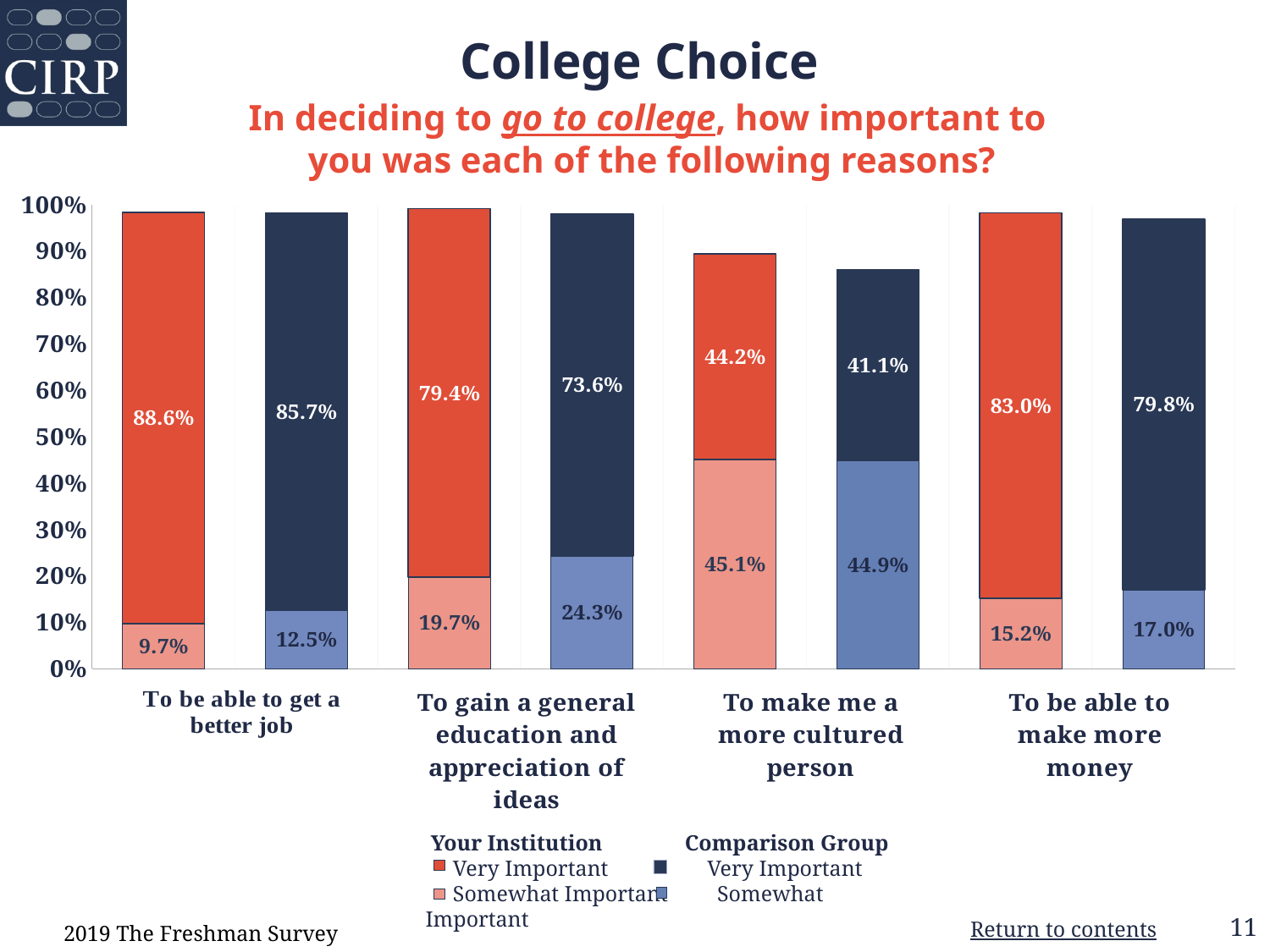
Which reason has the highest Very Important percentage for Your Institution? To be able to get a better job What percentage of Your Institution students rated "To be able to get a better job" as Very Important? 88.6% What kind of chart is shown on the slide? Stacked bar chart What colour represents Very Important for Your Institution? Red For "To gain a general education and appreciation of ideas", which group has the larger Very Important percentage, Your Institution or the Comparison Group? Your Institution What is the difference between Your Institution's and the Comparison Group's Very Important percentages for "To be able to make more money"? 3.2 percentage points What percentage of the Comparison Group rated "To gain a general education and appreciation of ideas" as Somewhat Important? 24.3% What is the Very Important percentage for the Comparison Group on "To make me a more cultured person"? 41.1% What is the combined Very Important and Somewhat Important percentage for Your Institution on "To make me a more cultured person"? 89.3% How many series does the legend list? 4 How many reasons (categories) are shown on the x axis? 4 Which reason has the lowest Very Important percentage for the Comparison Group? To make me a more cultured person